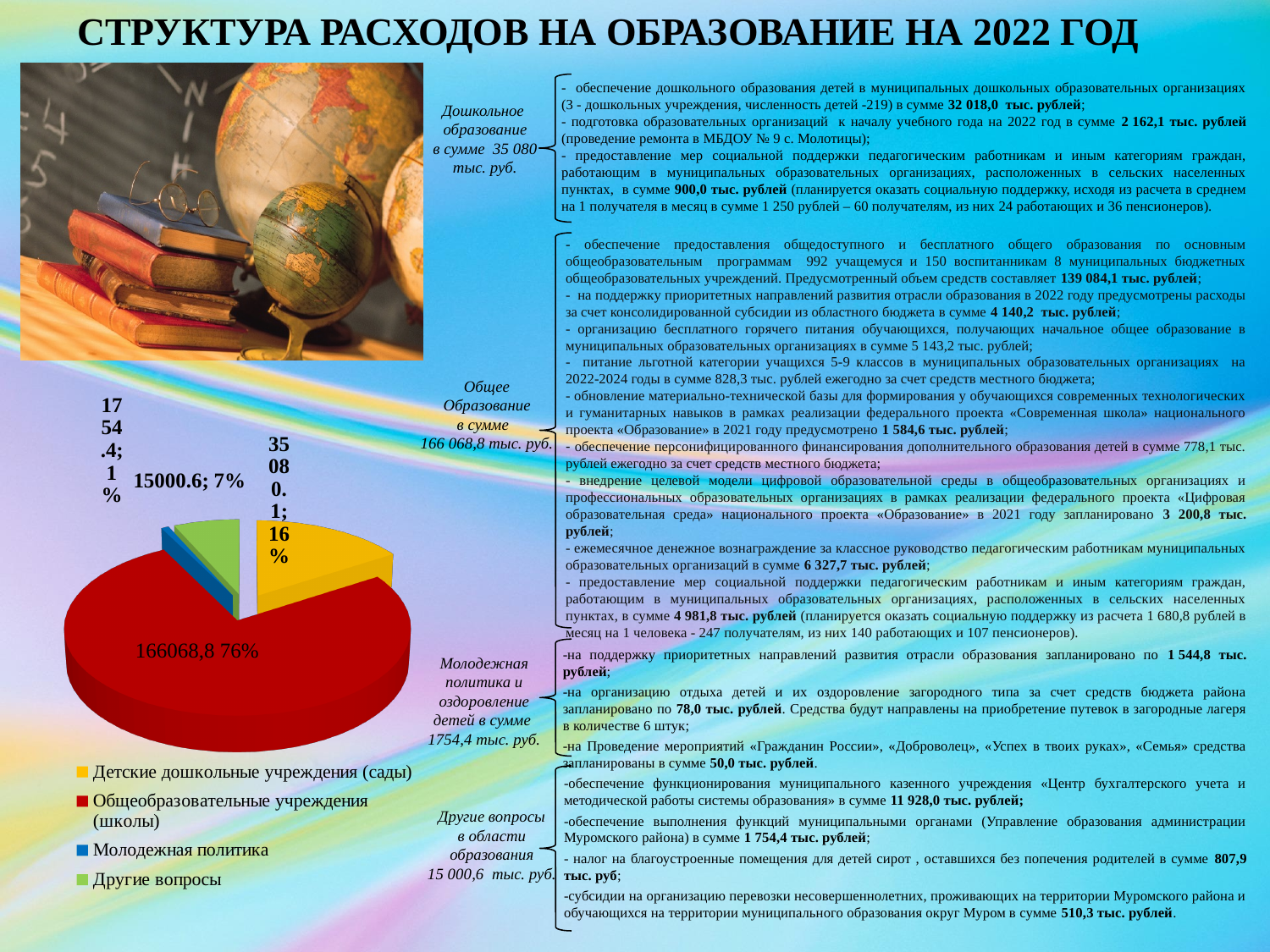
How many entries does the pie chart legend list? 4 What value is labelled on the slice for Молодежная политика? 1754.4 Which slice is larger: Детские дошкольные учреждения (сады) or Другие вопросы? Детские дошкольные учреждения (сады) By how many percentage points does the share of Общеобразовательные учреждения (школы) exceed that of Детские дошкольные учреждения (сады)? 60 percentage points Which category has the largest slice of the pie chart? Общеобразовательные учреждения (школы) Which category has the smallest slice of the pie chart? Молодежная политика What share of the pie does Детские дошкольные учреждения (сады) have? 16% How many slices does the pie chart have? 4 What share of the pie does Другие вопросы have? 7% What colour is the slice for Общеобразовательные учреждения (школы)? red What share of the pie does Общеобразовательные учреждения (школы) have? 76% What kind of chart is shown on the slide? pie chart